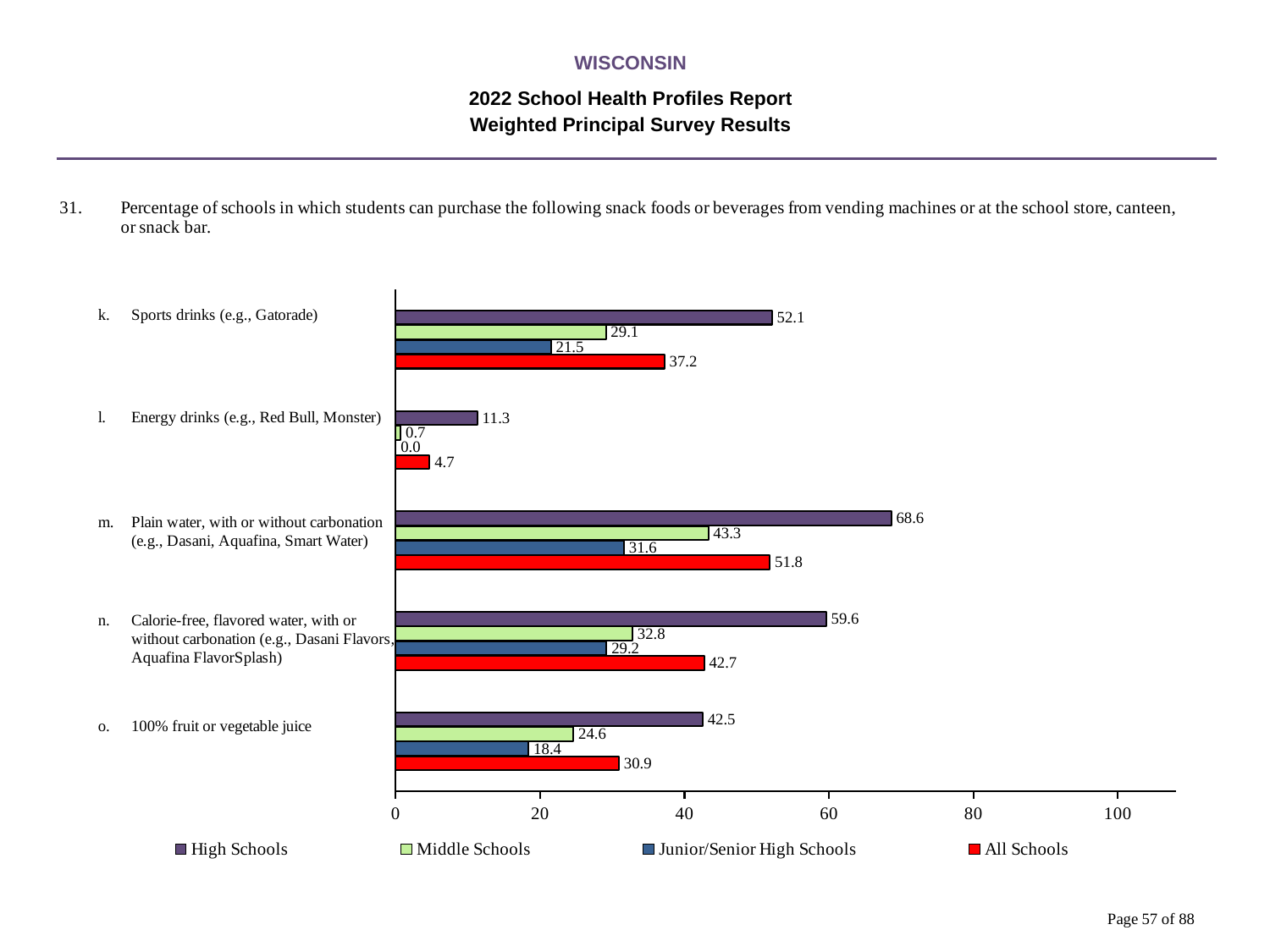
How many snack food or beverage categories are shown in the chart? 5 What is the difference between the High Schools and Middle Schools values for Calorie-free, flavored water? 26.8 What is the value for Middle Schools for 100% fruit or vegetable juice? 24.6 Is the All Schools value for Calorie-free, flavored water greater or less than 40? greater What is the value for High Schools for Sports drinks (e.g., Gatorade)? 52.1 How many series does the legend list? 4 What is the value for Junior/Senior High Schools for Energy drinks (e.g., Red Bull, Monster)? 0.0 Which category has the highest value for High Schools? Plain water, with or without carbonation Which is larger for Sports drinks: the Middle Schools value or the Junior/Senior High Schools value? Middle Schools Which category has the lowest value for All Schools? Energy drinks (e.g., Red Bull, Monster) What is the value for All Schools for Plain water, with or without carbonation? 51.8 What kind of chart is shown on the slide? bar chart